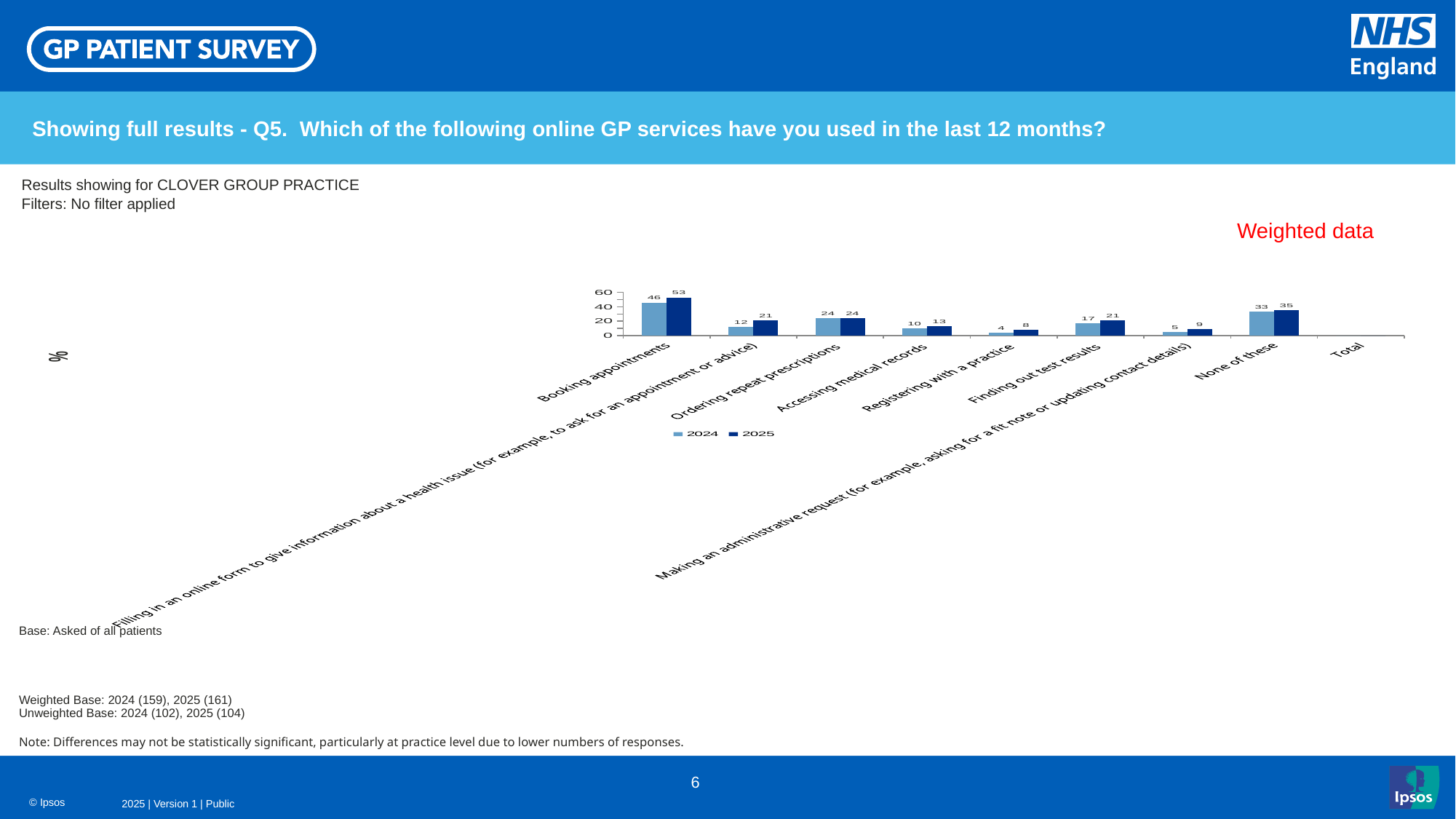
What are the two series named in the legend? 2024 and 2025 What is the difference between the 2025 and 2024 values for Booking appointments? 7 What is the 2025 value for Booking appointments? 53 What is the 2024 value for Ordering repeat prescriptions? 24 Is the 2024 value for Booking appointments greater or less than 40? greater What is the 2025 value for Finding out test results? 21 Which is larger for Accessing medical records, the 2024 value or the 2025 value? 2025 Which category has the highest 2025 value? Booking appointments What kind of chart is shown on the slide? Bar chart What is the 2024 value for None of these? 33 Which category has the lowest 2024 value? Registering with a practice How many series does the legend list? 2